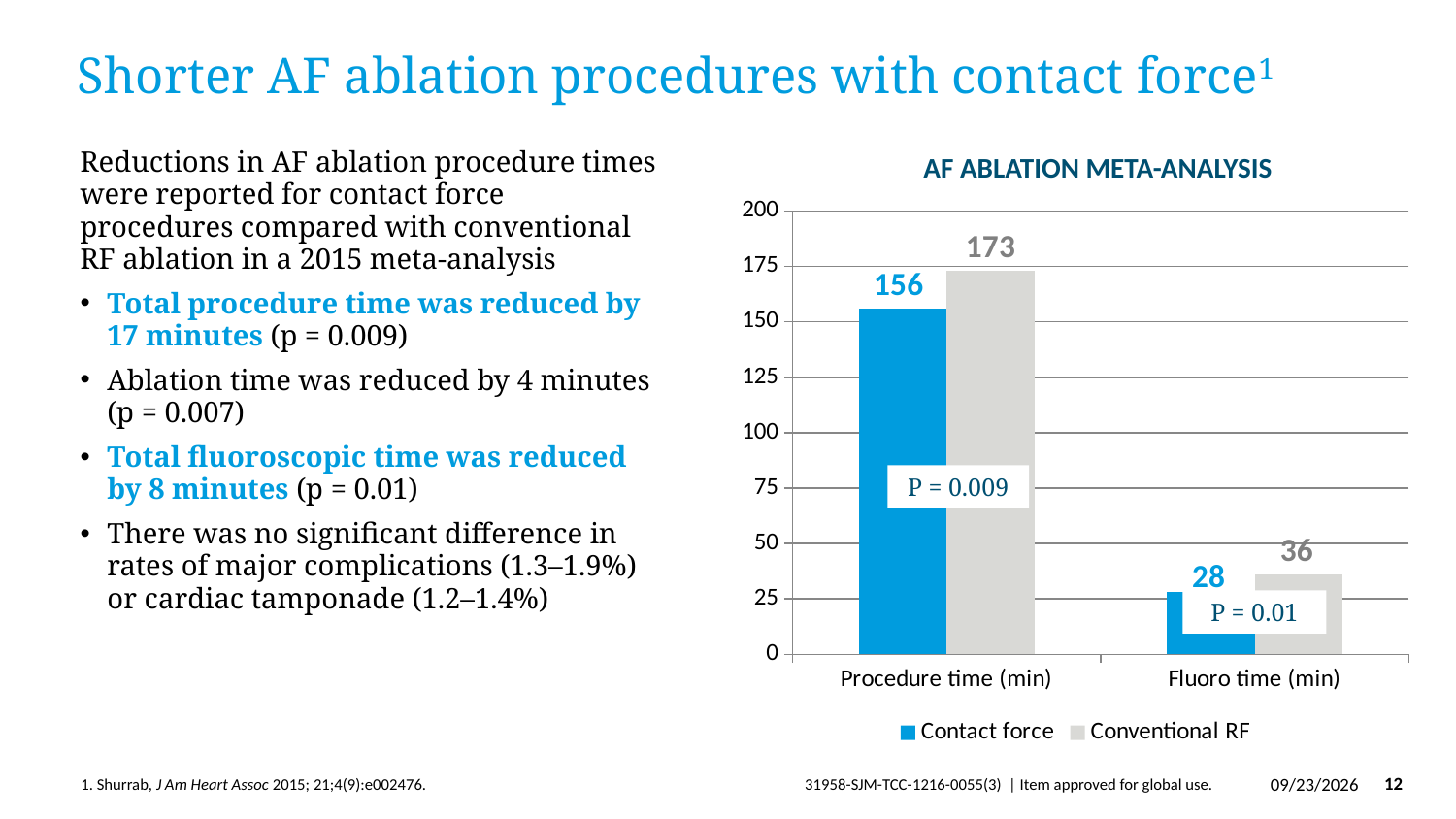
What is the difference between the Conventional RF and Contact force values for Fluoro time (min)? 8 Which series has the larger value for Fluoro time (min), Contact force or Conventional RF? Conventional RF What is the difference between the Conventional RF and Contact force values for Procedure time (min)? 17 How many series does the legend list? 2 What is the Conventional RF value for Procedure time (min)? 173 Which bar in the chart has the lowest value? Contact force, Fluoro time (min) What is the Contact force value for Procedure time (min)? 156 What is the Contact force value for Fluoro time (min)? 28 What is the Conventional RF value for Fluoro time (min)? 36 What is the title of the chart? AF ABLATION META-ANALYSIS Which bar in the chart has the highest value? Conventional RF, Procedure time (min) What kind of chart is shown on the slide? Bar chart